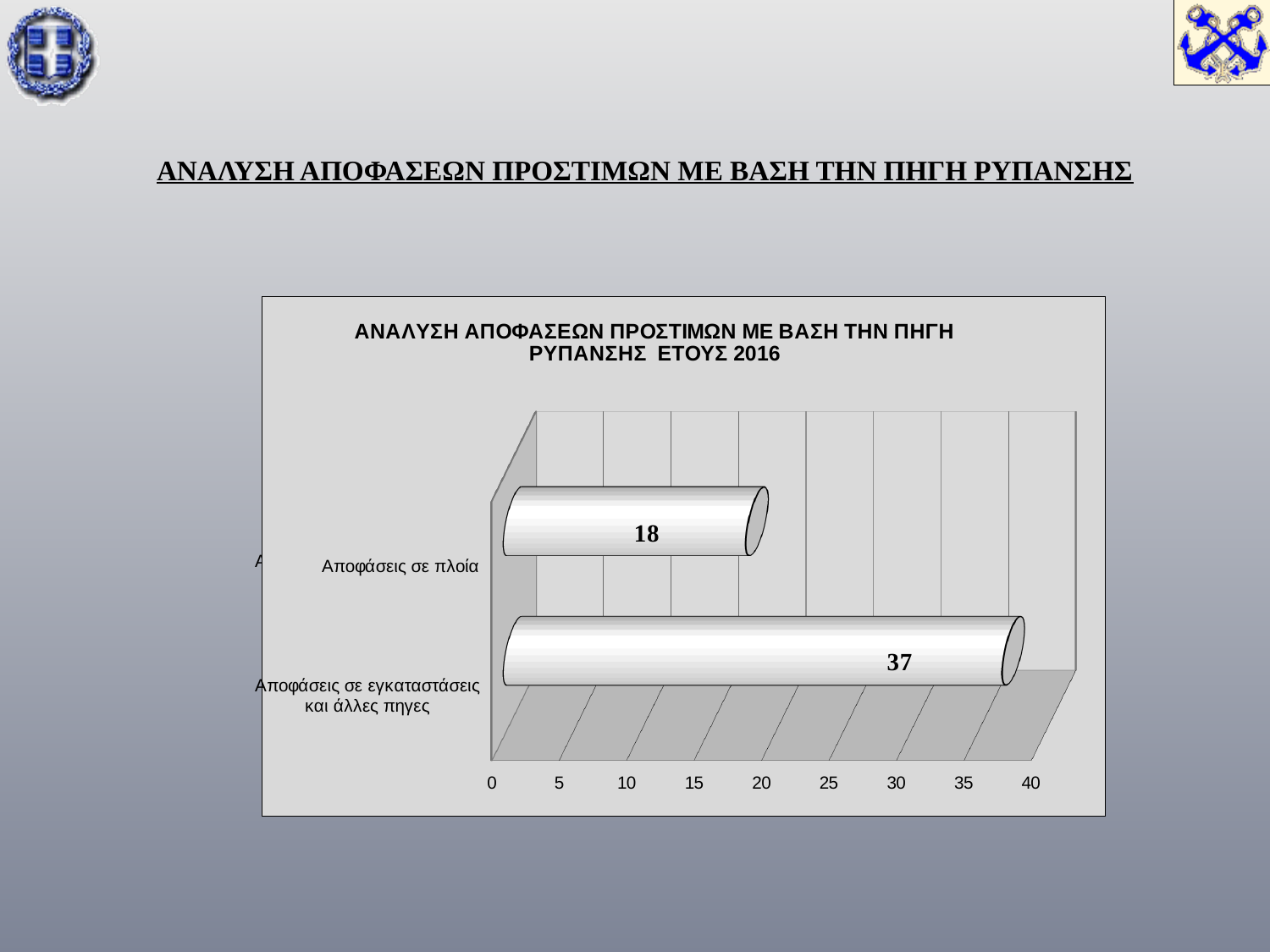
What is the value for Αποφάσεις σε εγκαταστάσεις και άλλες πηγες? 37 Is the value for Αποφάσεις σε εγκαταστάσεις και άλλες πηγες greater or less than 30? greater Is the value for Αποφάσεις σε πλοία greater or less than 20? less Which is larger: the value for Αποφάσεις σε πλοία or the value for Αποφάσεις σε εγκαταστάσεις και άλλες πηγες? Αποφάσεις σε εγκαταστάσεις και άλλες πηγες What is the value for Αποφάσεις σε πλοία? 18 How many categories are shown in the chart? 2 Which category has the highest value? Αποφάσεις σε εγκαταστάσεις και άλλες πηγες Which category has the lowest value? Αποφάσεις σε πλοία What is the title of the chart? ΑΝΑΛΥΣΗ ΑΠΟΦΑΣΕΩΝ ΠΡΟΣΤΙΜΩΝ ΜΕ ΒΑΣΗ ΤΗΝ ΠΗΓΗ ΡΥΠΑΝΣΗΣ ΕΤΟΥΣ 2016 What kind of chart is shown on the slide? bar chart What is the difference between the value for Αποφάσεις σε εγκαταστάσεις και άλλες πηγες and the value for Αποφάσεις σε πλοία? 19 What is the total of the two values shown in the chart? 55